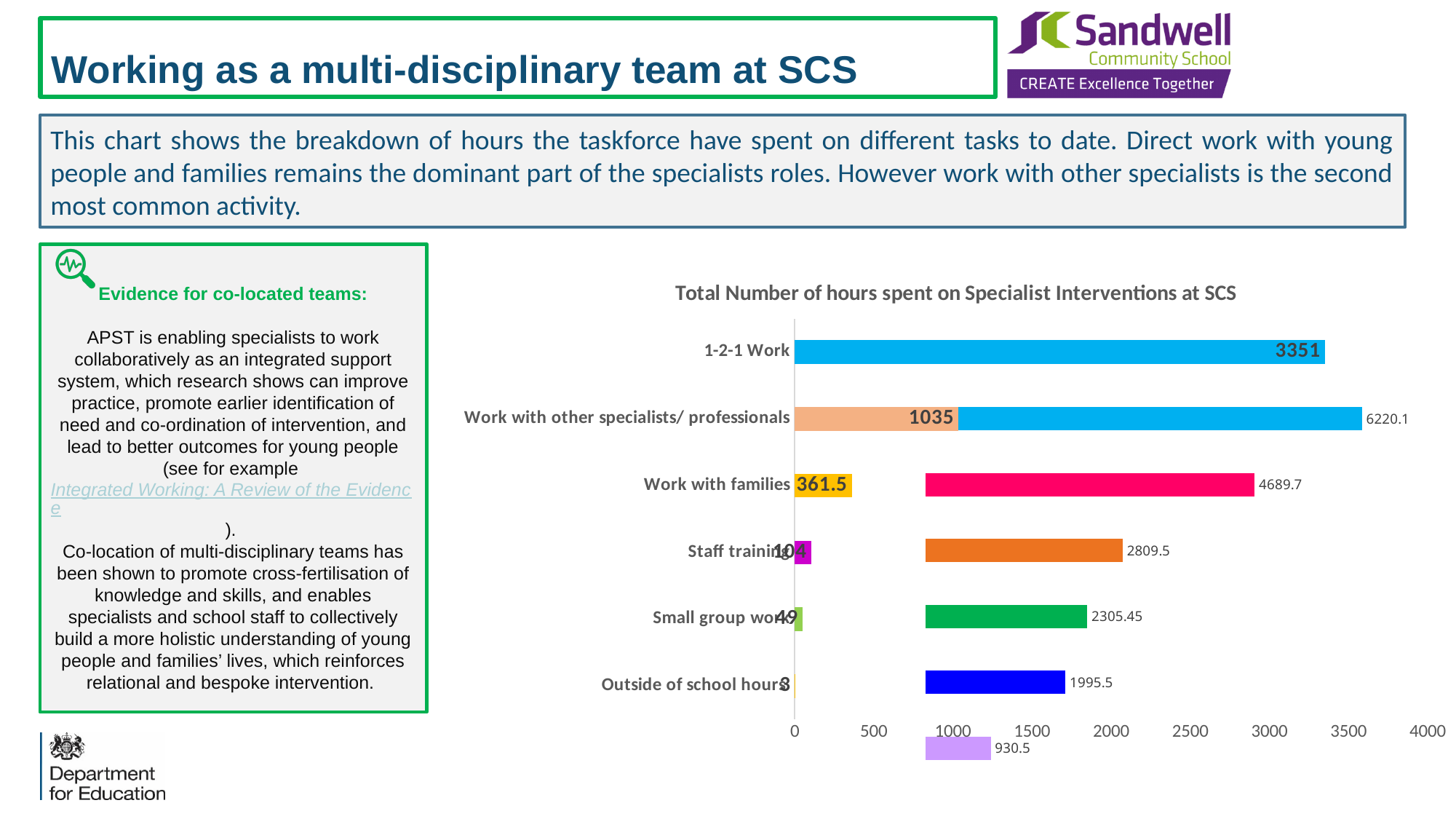
What is the title of the chart? Total Number of hours spent on Specialist Interventions at SCS What is the difference in hours between 1-2-1 Work and Work with other specialists/ professionals? 2316 Which category has the lowest number of hours in the chart? Outside of school hours What value is labelled on the Small group work bar? 49 How many categories are listed on the chart's vertical axis? 6 How many hours are shown for Work with families? 361.5 How many hours were spent on 1-2-1 Work according to the chart? 3351 Is the value for Work with families greater or less than 500? less What type of chart is used to show the hours spent on specialist interventions? bar chart Which category has the highest number of hours in the chart? 1-2-1 Work What is the value shown for Work with other specialists/ professionals? 1035 Which has more hours: Work with families or Staff training? Work with families